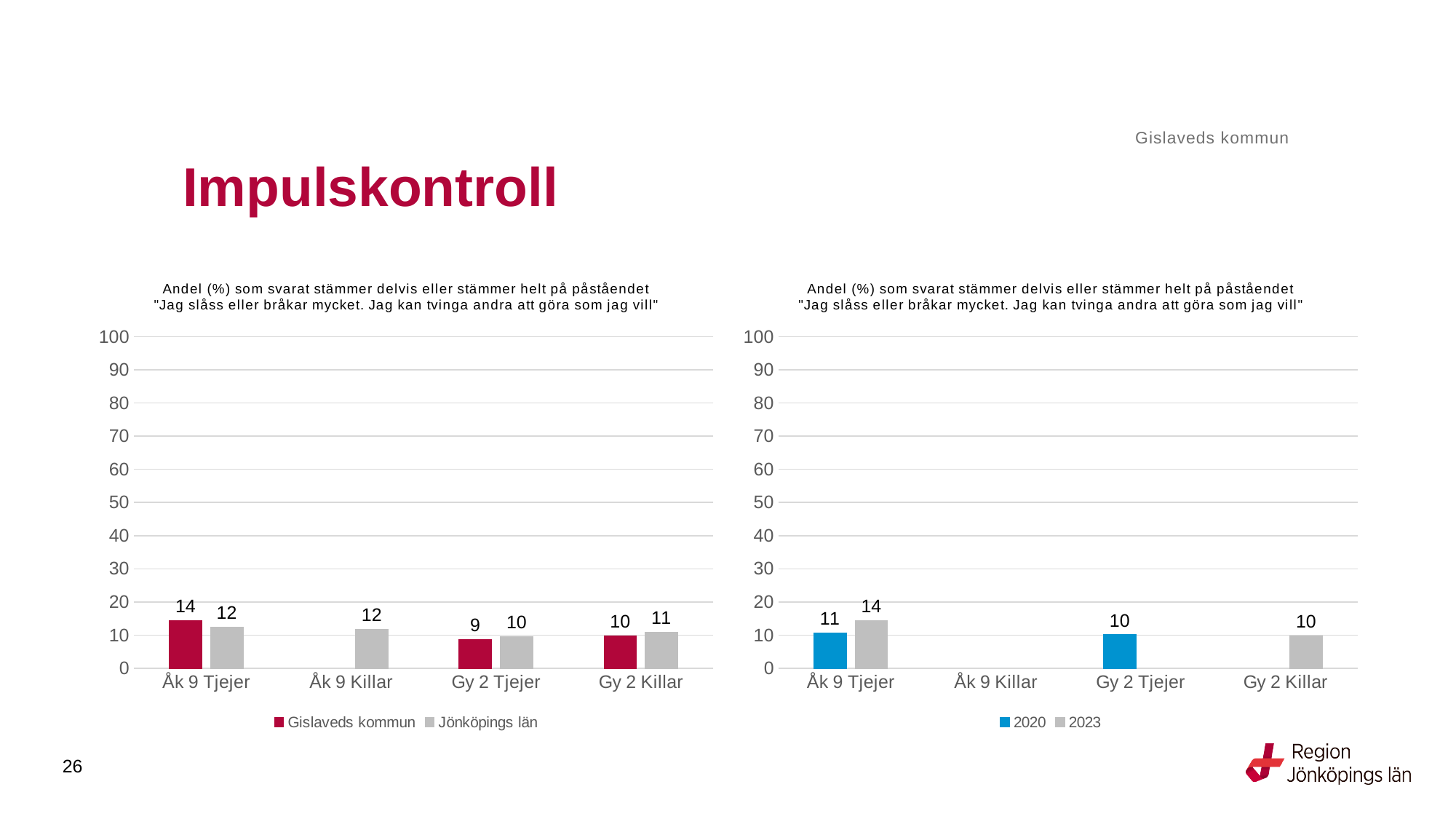
In the left chart, what is the difference between Gislaveds kommun and Jönköpings län for Åk 9 Tjejer? 2 In the left chart, what is the value for Jönköpings län for Gy 2 Killar? 11 In the right chart, is the value for 2023 for Gy 2 Killar greater or less than 20? less In the right chart, what is the value for 2020 for Gy 2 Tjejer? 10 In the left chart, which category has the lowest value for Gislaveds kommun? Gy 2 Tjejer In the right chart, what is the value for 2023 for Åk 9 Tjejer? 14 What kind of chart is the left chart? bar chart How many series does the legend of the right chart list? 2 In the right chart, what is the difference between 2023 and 2020 for Åk 9 Tjejer? 3 In the left chart, which is larger for Gy 2 Tjejer: Gislaveds kommun or Jönköpings län? Jönköpings län In the left chart, what is the value for Gislaveds kommun for Åk 9 Tjejer? 14 In the left chart, what is the value for Gislaveds kommun for Gy 2 Tjejer? 9